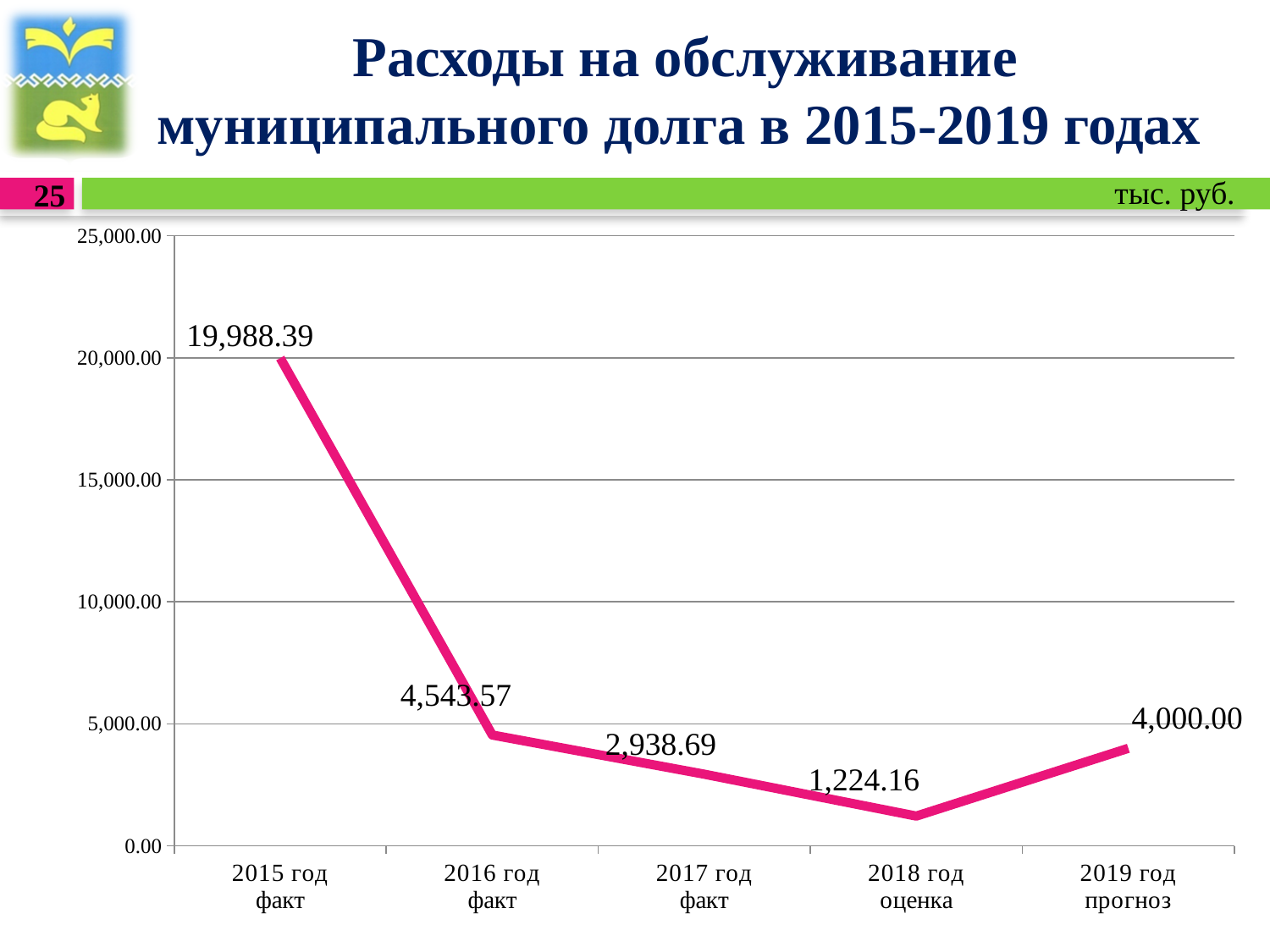
What is the value for 2018 год оценка? 1,224.16 What is the difference between the values for 2019 год прогноз and 2018 год оценка? 2,775.84 What is the difference between the values for 2015 год факт and 2016 год факт? 15,444.82 What is the value for 2017 год факт? 2,938.69 Which is larger, the value for 2016 год факт or the value for 2019 год прогноз? 2016 год факт Do the values rise or fall from 2015 год факт to 2018 год оценка? fall Which year has the highest value? 2015 год факт What is the value for 2015 год факт? 19,988.39 How many data points are plotted on the chart? 5 Which year has the lowest value? 2018 год оценка What kind of chart is shown on the slide? line chart What is the value for 2019 год прогноз? 4,000.00